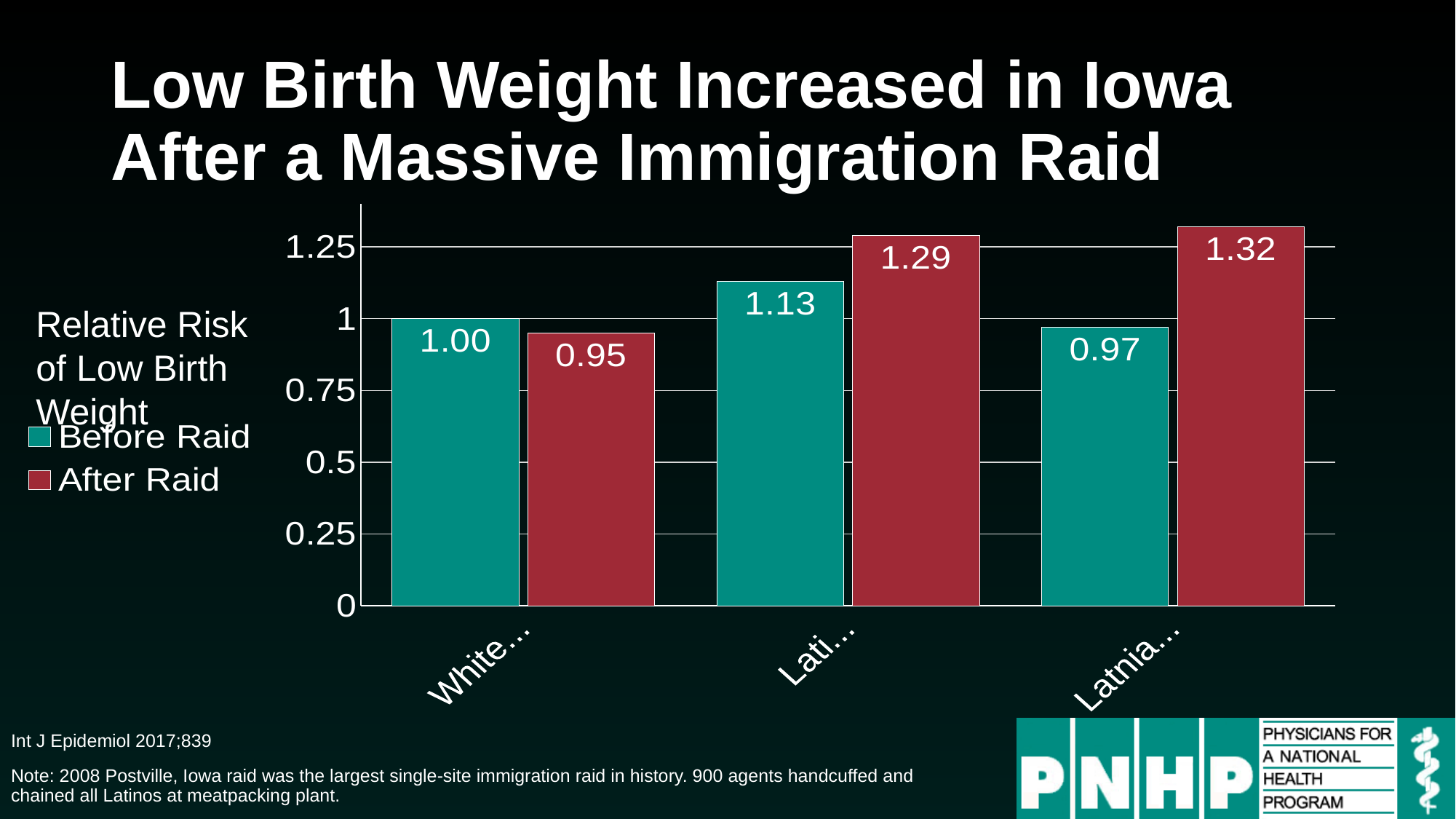
What is the After Raid value for the rightmost category? 1.32 What is the Before Raid value for the middle category? 1.13 How many series does the legend list? 2 What are the two entries in the legend? Before Raid, After Raid What is the After Raid value for the middle category? 1.29 What is the Before Raid value for the leftmost category? 1.00 What kind of chart is shown on the slide? bar chart What is the highest value shown on the chart? 1.32 For the middle category, which is larger: the Before Raid value or the After Raid value? After Raid How many categories are plotted along the x axis? 3 For the rightmost category, what is the difference between the After Raid and Before Raid values? 0.35 What is the lowest value shown on the chart? 0.95